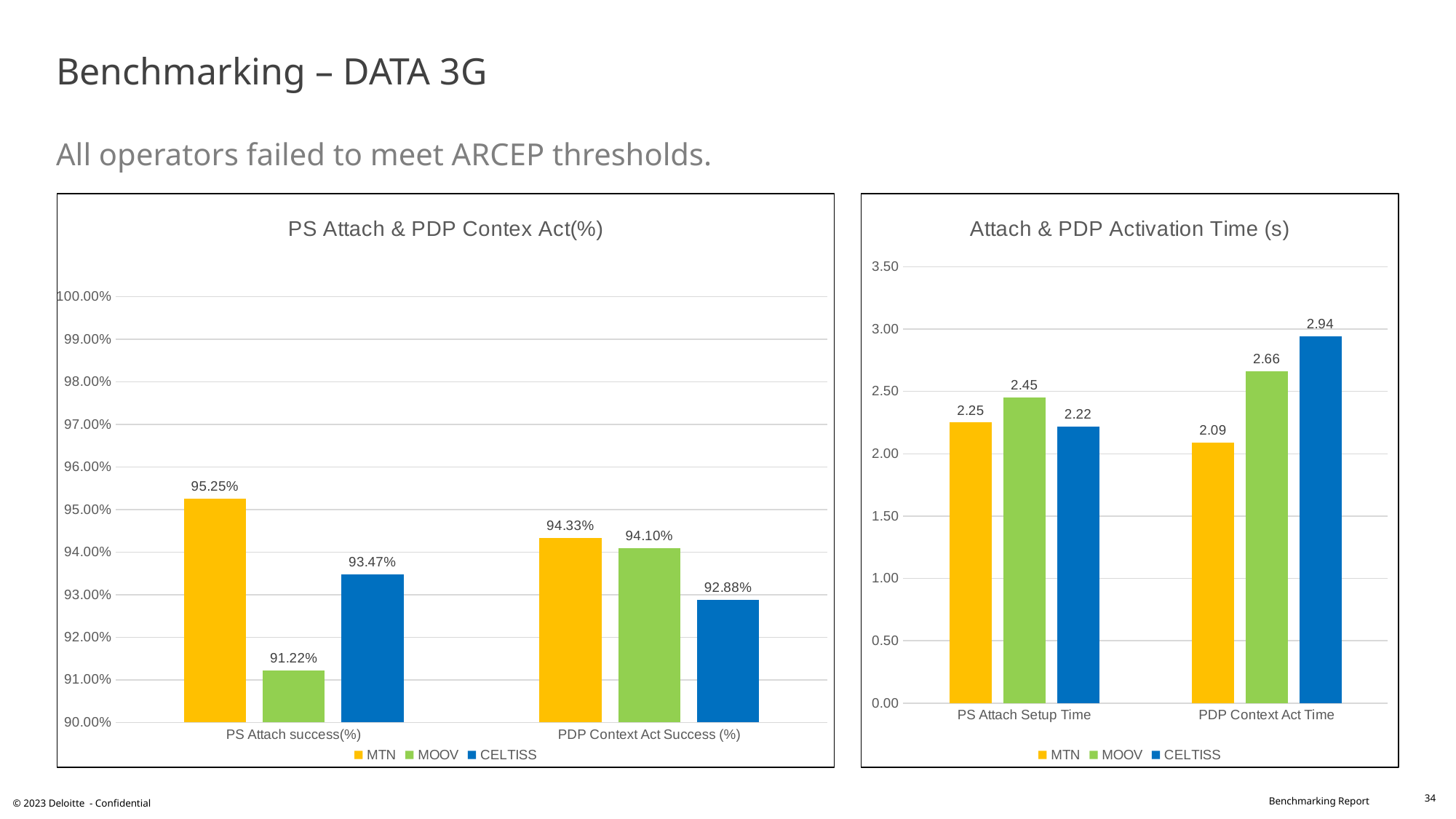
In the 'PS Attach & PDP Contex Act(%)' chart, what is the value for MOOV in PDP Context Act Success (%)? 94.10% In the 'Attach & PDP Activation Time (s)' chart, what is the PS Attach Setup Time for MOOV? 2.45 In the 'Attach & PDP Activation Time (s)' chart, what is the PDP Context Act Time for CELTISS? 2.94 In the 'PS Attach & PDP Contex Act(%)' chart, what is the difference between MTN and CELTISS for PDP Context Act Success (%)? 1.45% In the 'PS Attach & PDP Contex Act(%)' chart, what colour represents CELTISS? Blue In the 'Attach & PDP Activation Time (s)' chart, what is the difference between MOOV's PDP Context Act Time and PS Attach Setup Time? 0.21 What kind of chart is the 'Attach & PDP Activation Time (s)' chart? Bar chart In the 'PS Attach & PDP Contex Act(%)' chart, how many series does the legend list? 3 In the 'PS Attach & PDP Contex Act(%)' chart, what is the value for MTN in PS Attach success(%)? 95.25% In the 'Attach & PDP Activation Time (s)' chart, which operator has the lowest PDP Context Act Time? MTN In the 'Attach & PDP Activation Time (s)' chart, which is larger: the PS Attach Setup Time for MTN or for CELTISS? MTN In the 'PS Attach & PDP Contex Act(%)' chart, which operator has the lowest PS Attach success(%)? MOOV